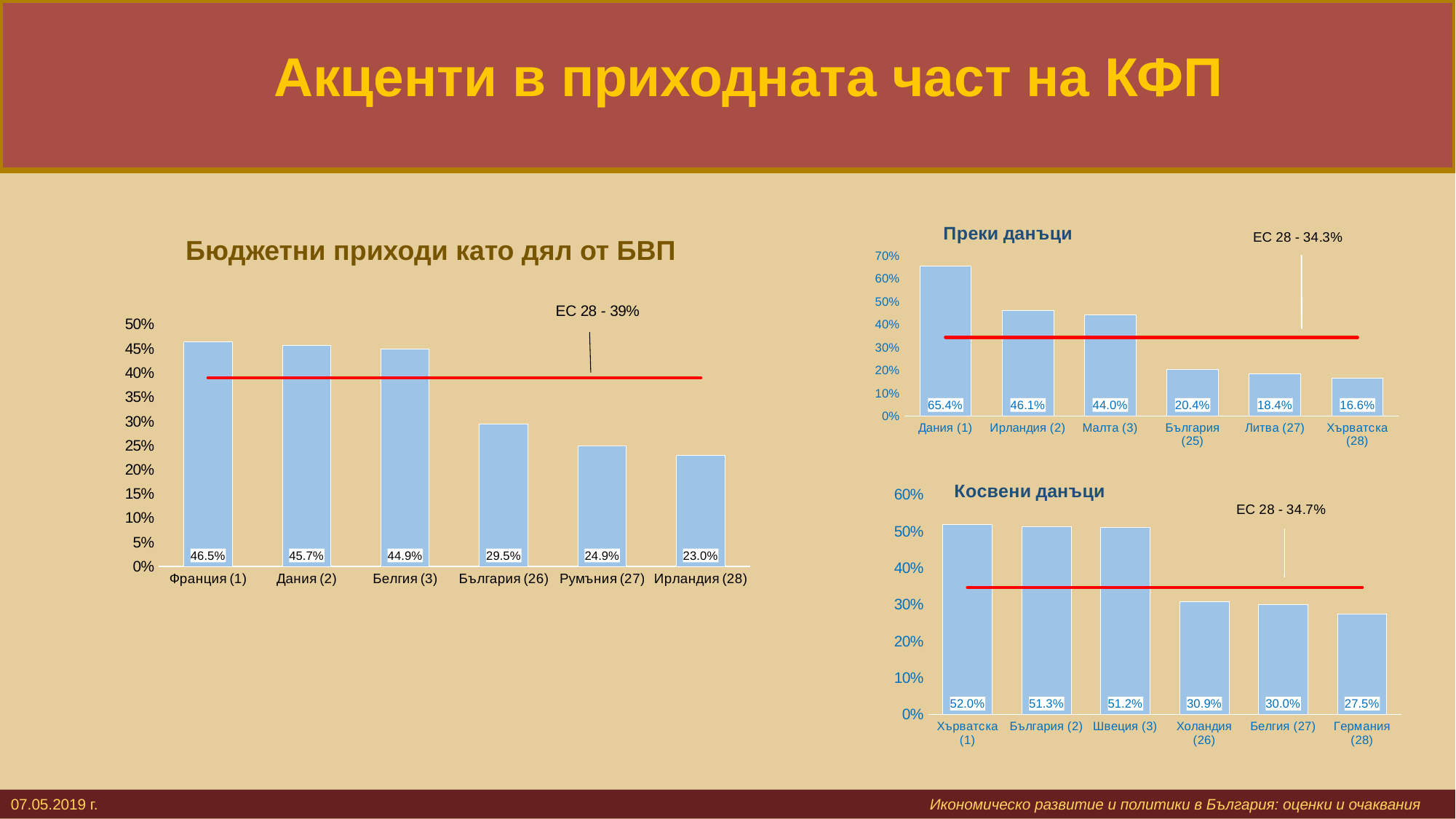
What type of chart is 'Косвени данъци'? bar chart In the chart 'Косвени данъци', do the values rise or fall from left to right along the x axis? fall In the chart 'Бюджетни приходи като дял от БВП', what is the difference between the values for Дания (2) and България (26)? 16.2% In the chart 'Преки данъци', what is the value for Дания (1)? 65.4% In the chart 'Преки данъци', which category has the highest value? Дания (1) In the chart 'Косвени данъци', what is the difference between the values for Хърватска (1) and Холандия (26)? 21.1% In the chart 'Бюджетни приходи като дял от БВП', what EC 28 value is shown by the red line? 39% In the chart 'Преки данъци', which is larger, the value for Ирландия (2) or Малта (3)? Ирландия (2) In the chart 'Бюджетни приходи като дял от БВП', which category has the lowest value? Ирландия (28) In the chart 'Бюджетни приходи като дял от БВП', what is the value for Франция (1)? 46.5% In the chart 'Преки данъци', how many categories are plotted? 6 In the chart 'Косвени данъци', what is the value for Германия (28)? 27.5%